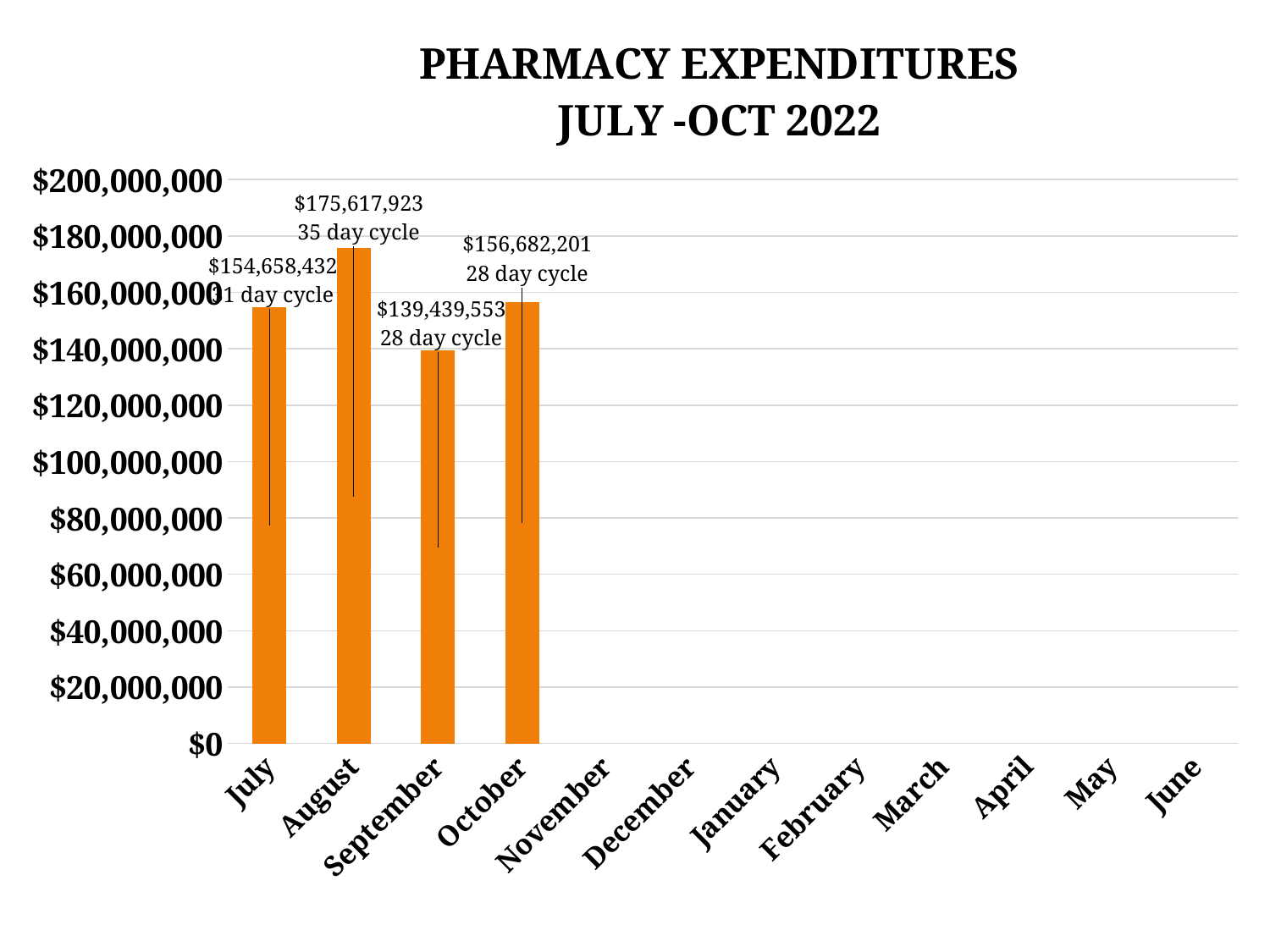
What is the pharmacy expenditure for October? $156,682,201 Is the expenditure for September greater or less than $140,000,000? less How many days is the billing cycle noted for August? 35 day cycle What kind of chart is shown on the slide? Bar chart What is the difference between the August and September expenditures? $36,178,370 What is the pharmacy expenditure for July? $154,658,432 What is the pharmacy expenditure for September? $139,439,553 How many months have a bar plotted on the chart? 4 What is the title of the chart? PHARMACY EXPENDITURES JULY -OCT 2022 What is the pharmacy expenditure for August? $175,617,923 Which month has the highest pharmacy expenditure? August Which month has the lowest pharmacy expenditure among the plotted months? September